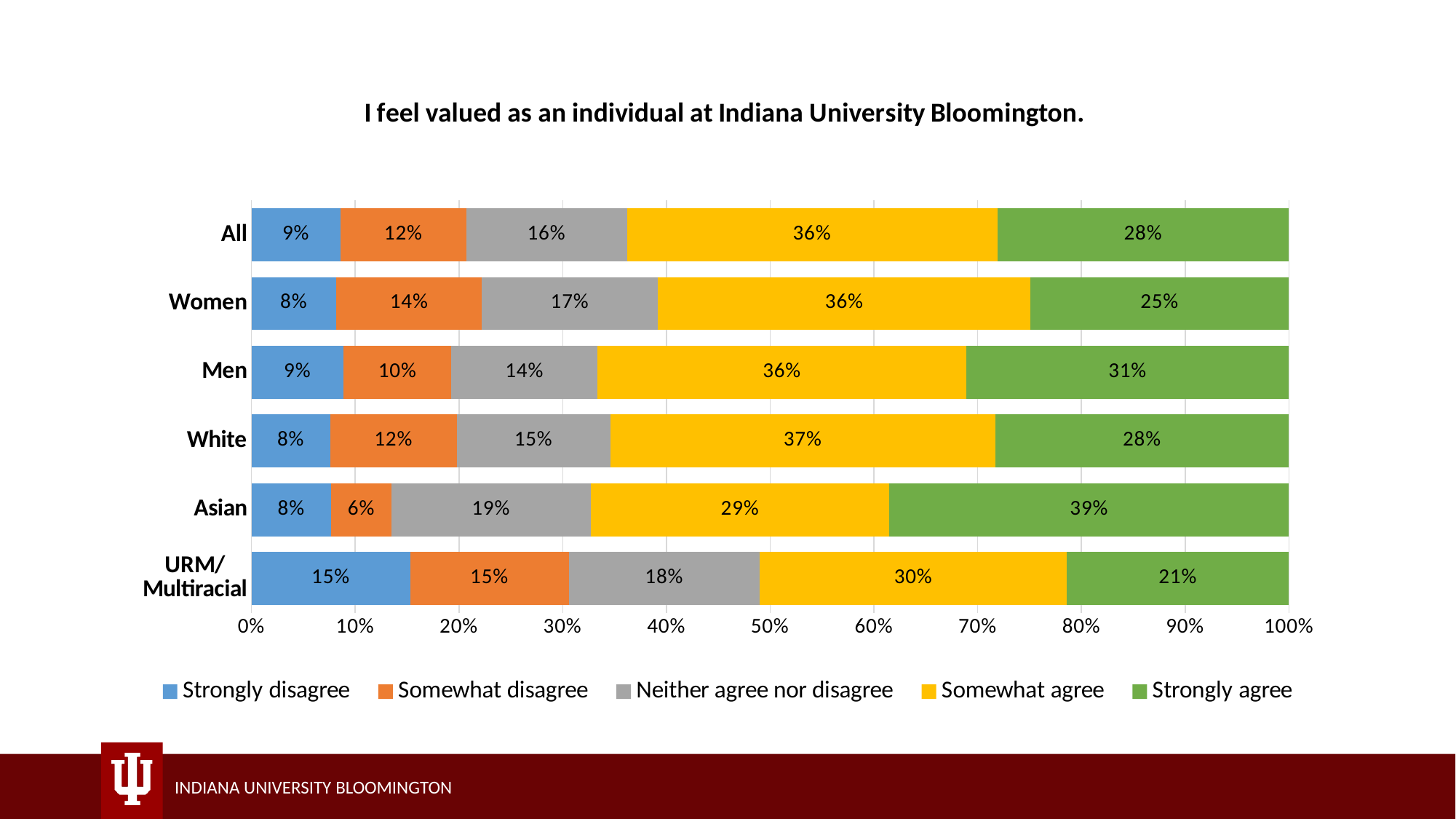
What is the combined percentage of Somewhat agree and Strongly agree responses for the All group? 64% Which group has the lowest percentage of Strongly agree responses? URM/Multiracial Which group has the highest percentage of Strongly agree responses? Asian What is the difference between the Strongly agree percentage for Men and for Women? 6% What percentage of Asian respondents strongly agree that they feel valued as an individual at Indiana University Bloomington? 39% What colour represents the Somewhat agree response in the chart? Yellow How many groups are shown on the chart? 6 What percentage of URM/Multiracial respondents strongly disagree? 15% How many response categories does the legend list? 5 Which group has a larger Somewhat disagree percentage, Women or Men? Women What kind of chart is shown on the slide? Stacked bar chart What percentage of Women respondents neither agree nor disagree? 17%